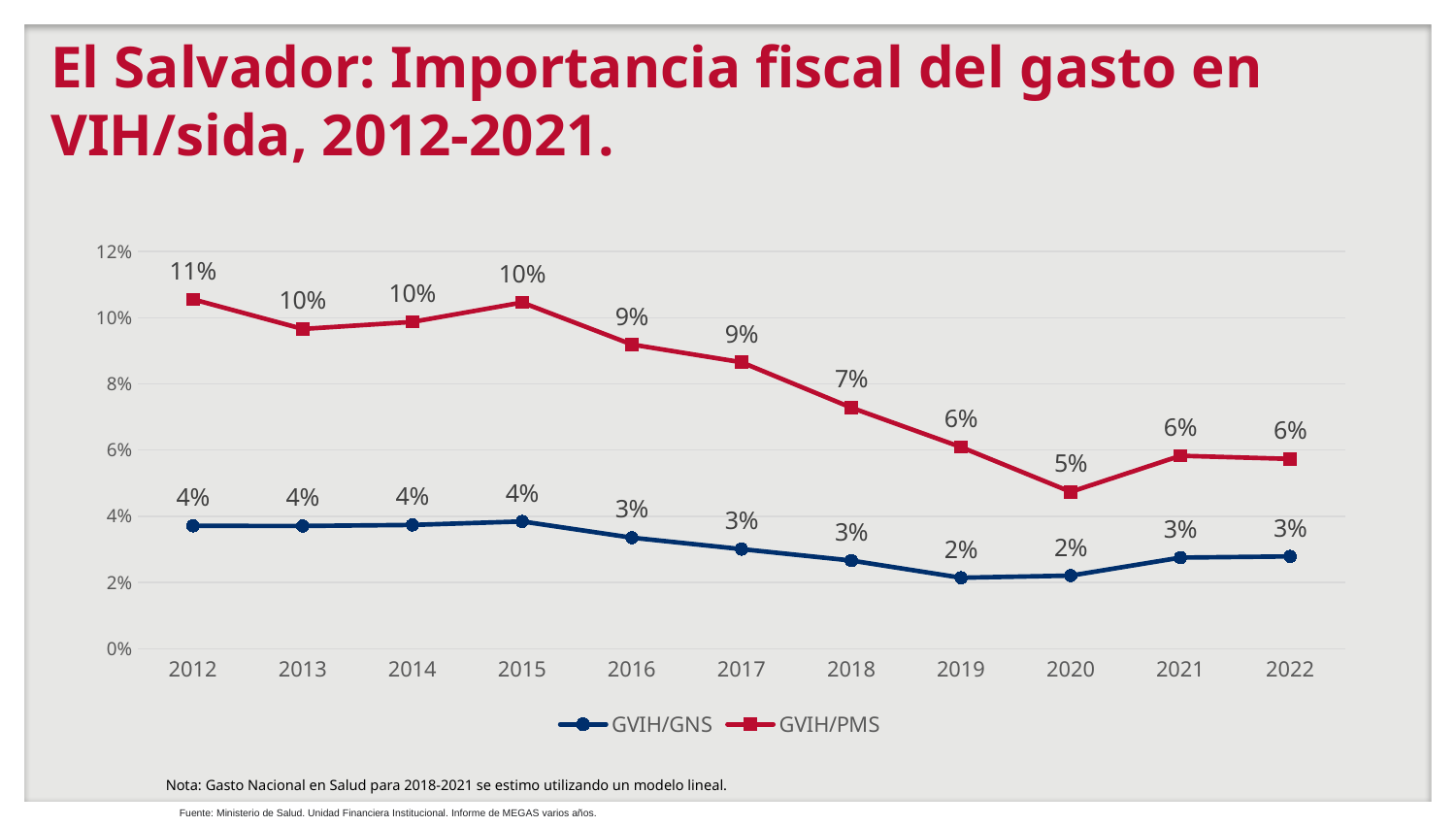
In which year is GVIH/PMS lowest? 2020 In which year is GVIH/PMS highest? 2012 What kind of chart is shown on the slide? line chart What is the difference between GVIH/PMS and GVIH/GNS in 2012? 7% Which series has the larger value in 2018, GVIH/GNS or GVIH/PMS? GVIH/PMS What is the value of GVIH/GNS in 2019? 2% How many series does the legend list? 2 Is the value for GVIH/PMS in 2018 greater or less than 8%? less What is the value of GVIH/PMS in 2020? 5% How many years are plotted on the x axis? 11 What is the value of GVIH/PMS in 2012? 11% Does GVIH/PMS generally rise or fall from 2012 to 2020? fall